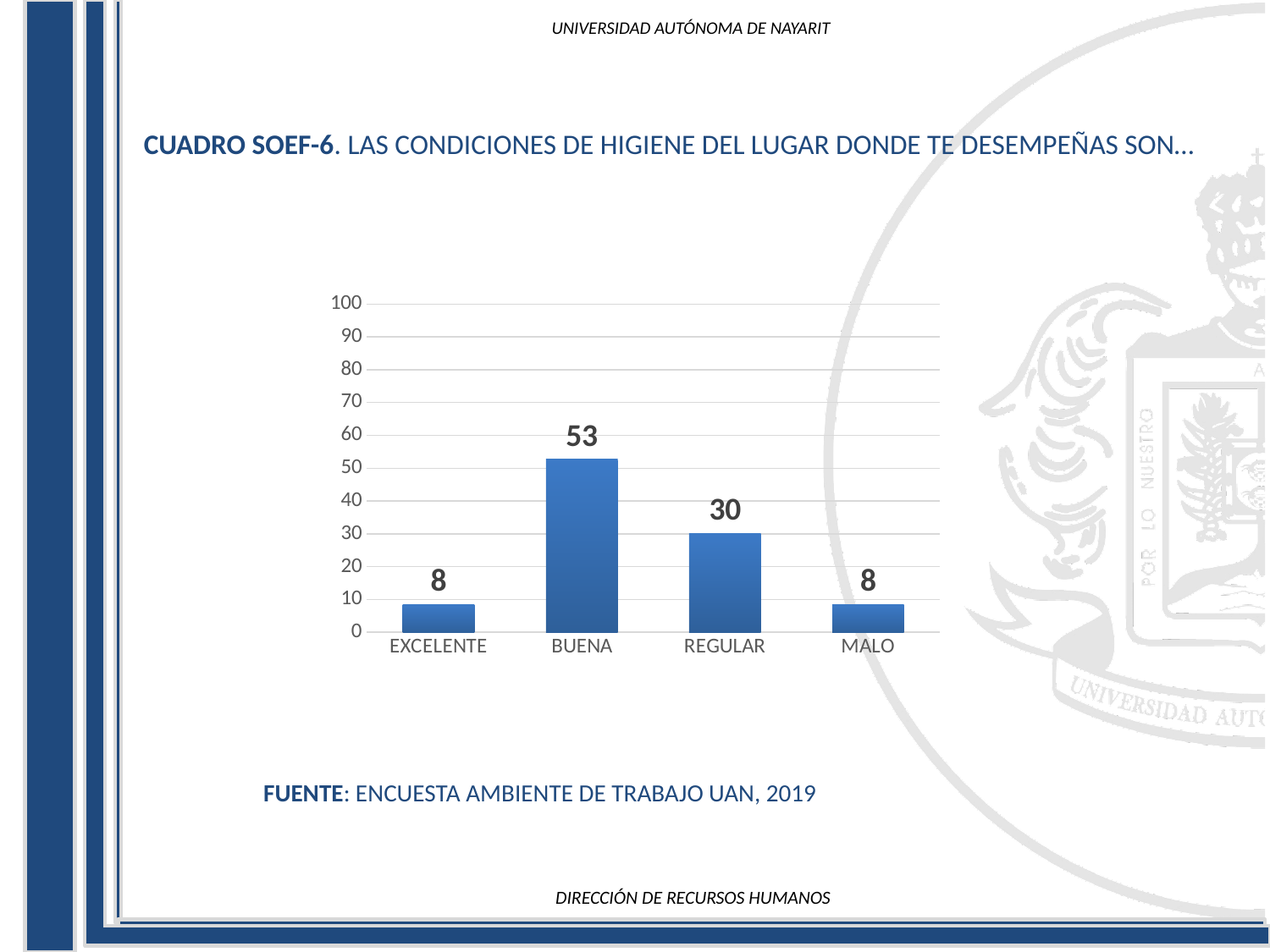
Which is larger, the value for BUENA or the value for REGULAR? BUENA Is the value for MALO greater or less than 10? less What is the source cited below the chart? ENCUESTA AMBIENTE DE TRABAJO UAN, 2019 What is the value for REGULAR? 30 Is the value for BUENA greater or less than 50? greater What kind of chart is shown on the slide? bar chart What is the difference between the values for BUENA and REGULAR? 23 What is the difference between the values for REGULAR and MALO? 22 What is the value for BUENA? 53 Which category has the highest value? BUENA What is the value for EXCELENTE? 8 How many categories are shown on the x axis? 4